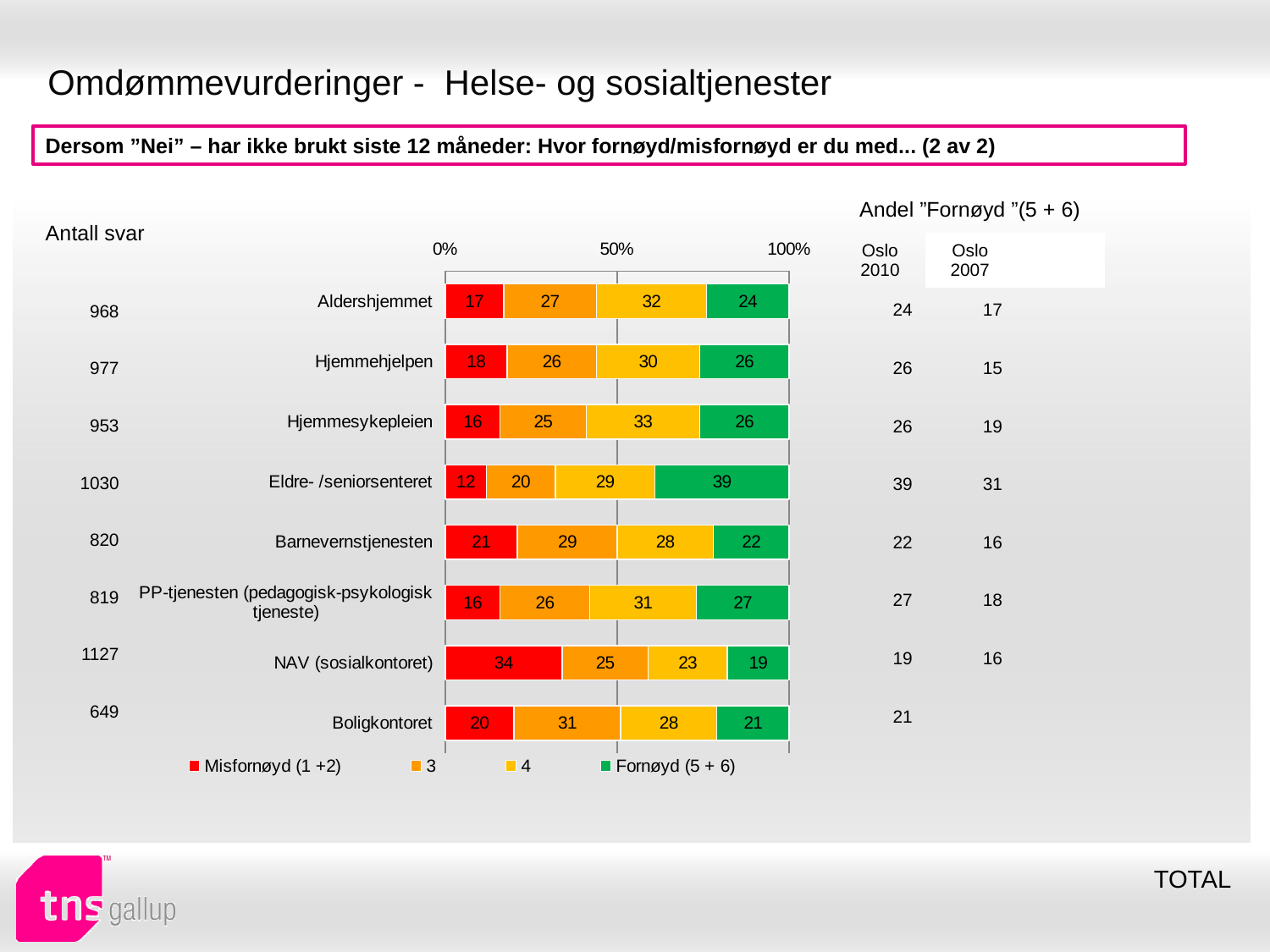
How many categories are shown in the chart? 8 What is the value of the "4" segment for Hjemmesykepleien? 33 What is the value of the "Fornøyd (5 + 6)" segment for Eldre- /seniorsenteret? 39 What is the value of the "Misfornøyd (1 +2)" segment for NAV (sosialkontoret)? 34 How many series does the legend list? 4 Which category has the lowest "Fornøyd (5 + 6)" value? NAV (sosialkontoret) Which category has the lowest "Misfornøyd (1 +2)" value? Eldre- /seniorsenteret Which category has the highest "Fornøyd (5 + 6)" value? Eldre- /seniorsenteret Which has a larger "Misfornøyd (1 +2)" value, Barnevernstjenesten or Boligkontoret? Barnevernstjenesten What is the difference between the "Fornøyd (5 + 6)" values for Eldre- /seniorsenteret and NAV (sosialkontoret)? 20 What kind of chart is shown on the slide? Stacked bar chart What is the total of the stacked bar for Aldershjemmet? 100